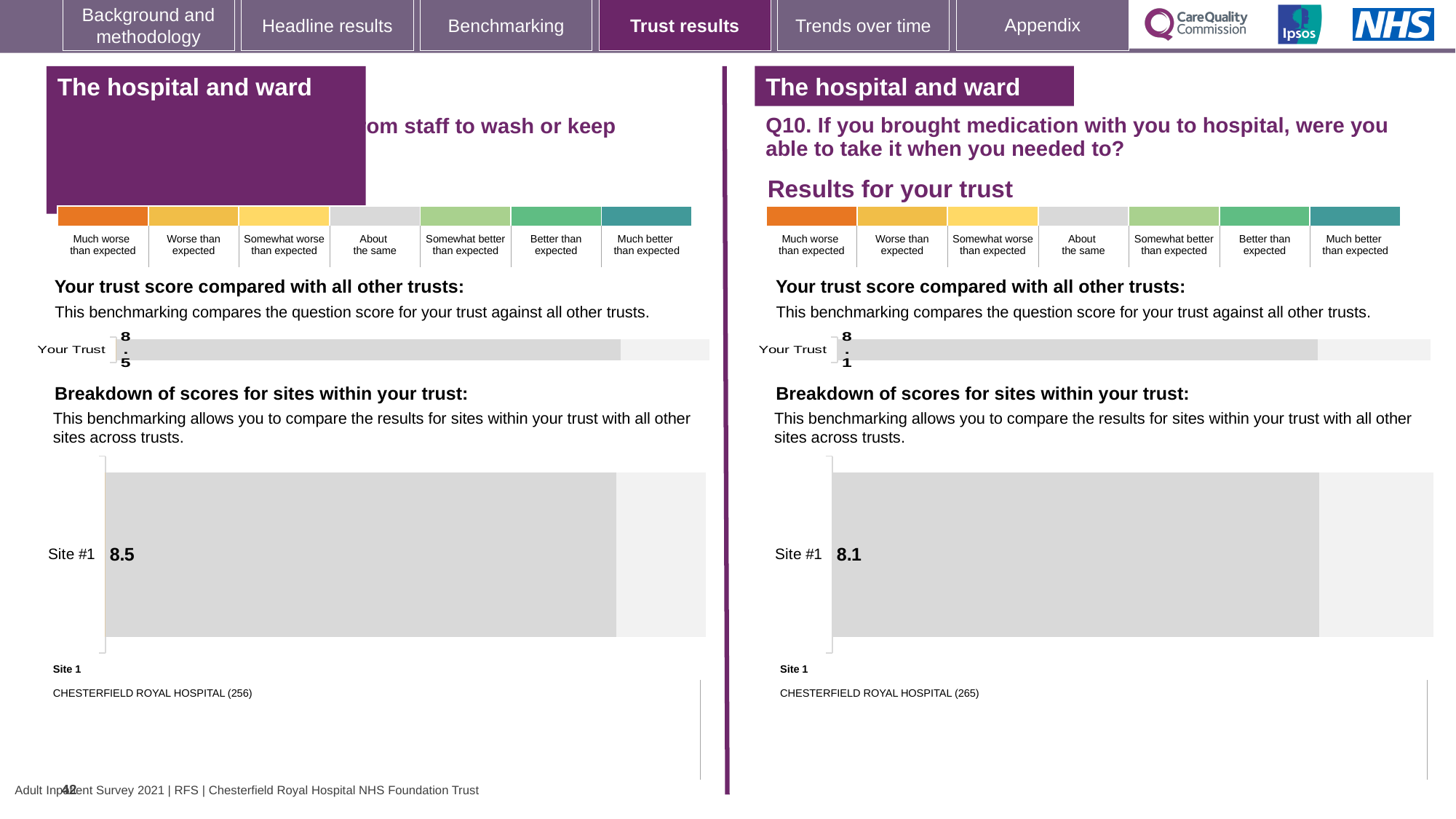
What is the difference between the Site #1 score on the left half of the slide and the Site #1 score on the right half (Q10)? 0.4 On the right half of the slide (Q10), is the Site #1 score greater or less than the Your Trust score, or are they equal? Equal On the right half of the slide (Q10), which site name is listed as Site 1 below the chart? CHESTERFIELD ROYAL HOSPITAL (265) On the right half of the slide (Q10), what is the score shown for Your Trust in the trust score comparison chart? 8.1 On the left half of the slide, what is the score shown for Site #1 in the breakdown of scores for sites within your trust? 8.5 How many sites are shown in the breakdown of scores chart on the right half of the slide (Q10)? 1 What type of chart is used to show the Site #1 score on the right half of the slide (Q10)? Bar chart On the right half of the slide (Q10), what is the score shown for Site #1 in the breakdown of scores for sites within your trust? 8.1 On the left half of the slide, what is the score shown for Your Trust in the trust score comparison chart? 8.5 How many sites are shown in the breakdown of scores chart on the left half of the slide? 1 Which is larger: the Site #1 score on the left half of the slide or the Site #1 score on the right half (Q10)? Left half (8.5) On the left half of the slide, which site name is listed as Site 1 below the chart? CHESTERFIELD ROYAL HOSPITAL (256)